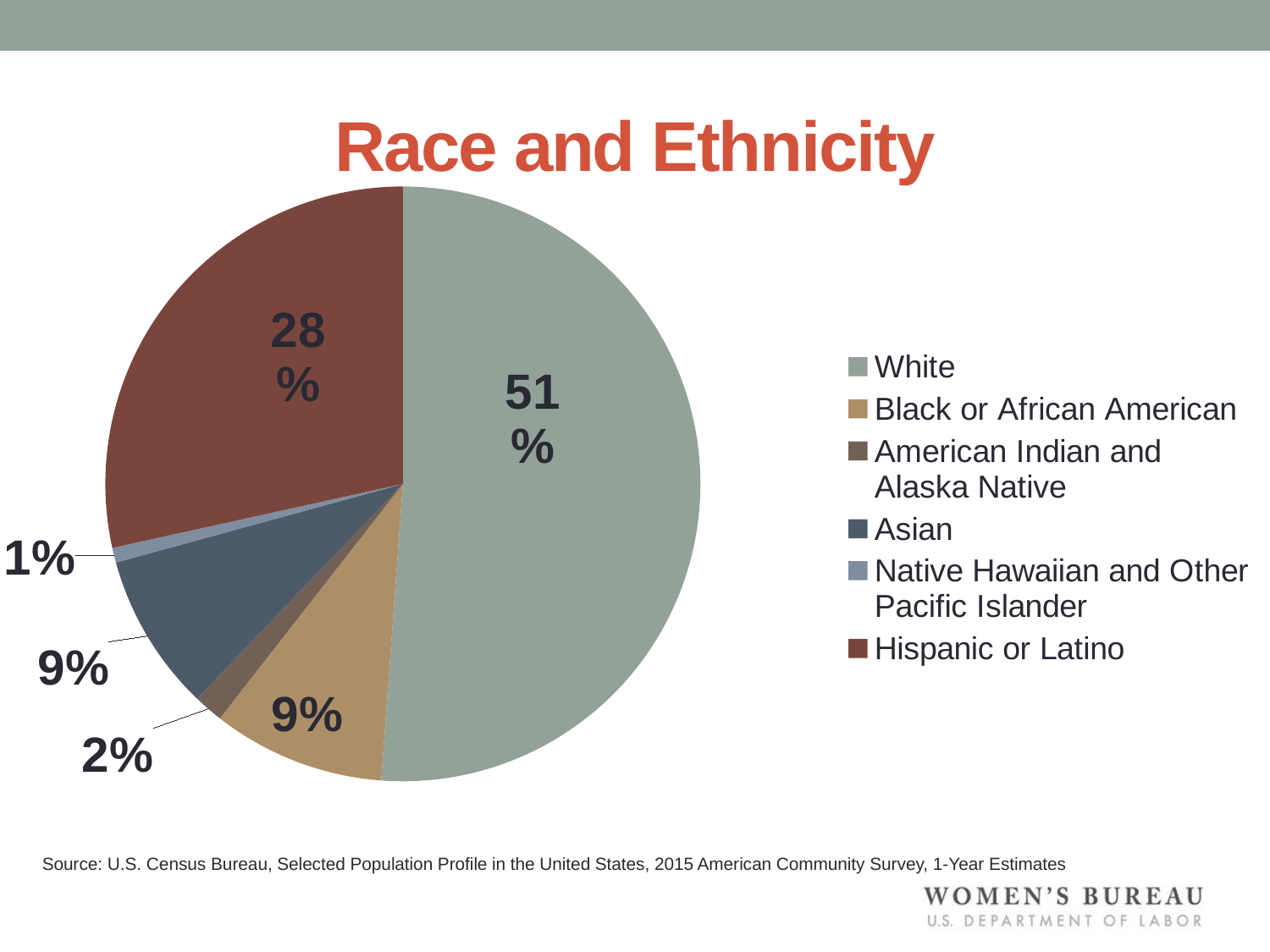
What share of the pie is labelled for American Indian and Alaska Native? 2% What type of chart is shown on the slide? pie chart What share of the pie is labelled for White? 51% Which category has the smallest slice of the pie? Native Hawaiian and Other Pacific Islander What share of the pie is labelled for Asian? 9% What is the difference in percentage points between the White slice and the Hispanic or Latino slice? 23 What is the title of the chart? Race and Ethnicity How many categories does the legend list? 6 What share of the pie is labelled for Hispanic or Latino? 28% What share of the pie is labelled for Native Hawaiian and Other Pacific Islander? 1% Which category has the largest slice of the pie? White Which is larger, the Hispanic or Latino slice or the Black or African American slice? Hispanic or Latino